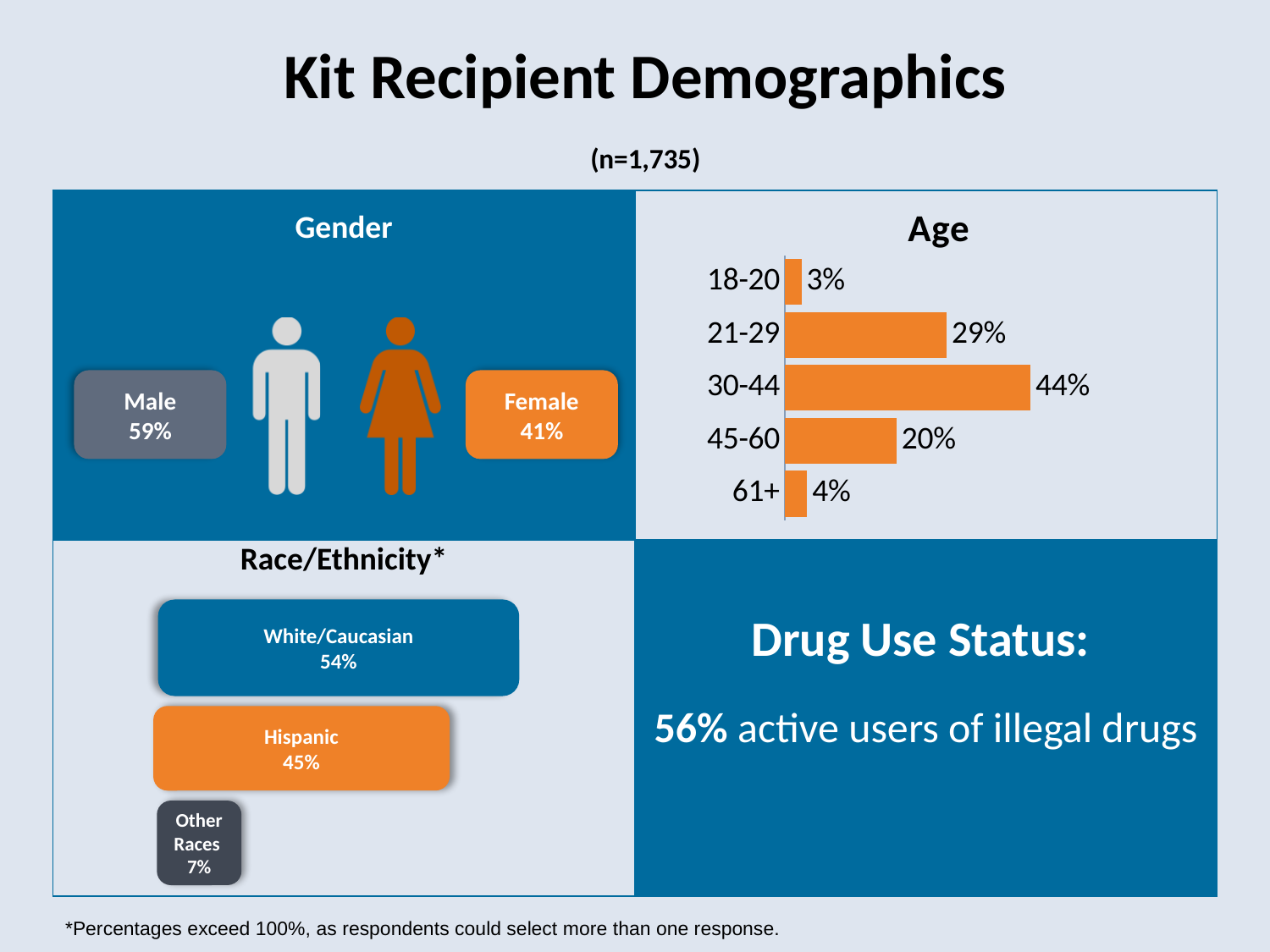
In the Race/Ethnicity chart, which category has the lowest percentage? Other Races What type of chart is the Age chart? Bar chart In the Age chart, what percentage of kit recipients are aged 30-44? 44% In the Age chart, which age group has the lowest percentage? 18-20 In the Gender chart, what is the difference in percentage points between Male and Female recipients? 18 In the Race/Ethnicity chart, what percentage of kit recipients are Hispanic? 45% In the Age chart, what percentage of kit recipients are aged 21-29? 29% In the Age chart, what is the difference in percentage points between the 30-44 and 45-60 age groups? 24 How many age groups are shown in the Age chart? 5 In the Age chart, what percentage of kit recipients are aged 61+? 4% In the Age chart, which age group has a larger share: 21-29 or 45-60? 21-29 In the Age chart, which age group has the highest percentage? 30-44